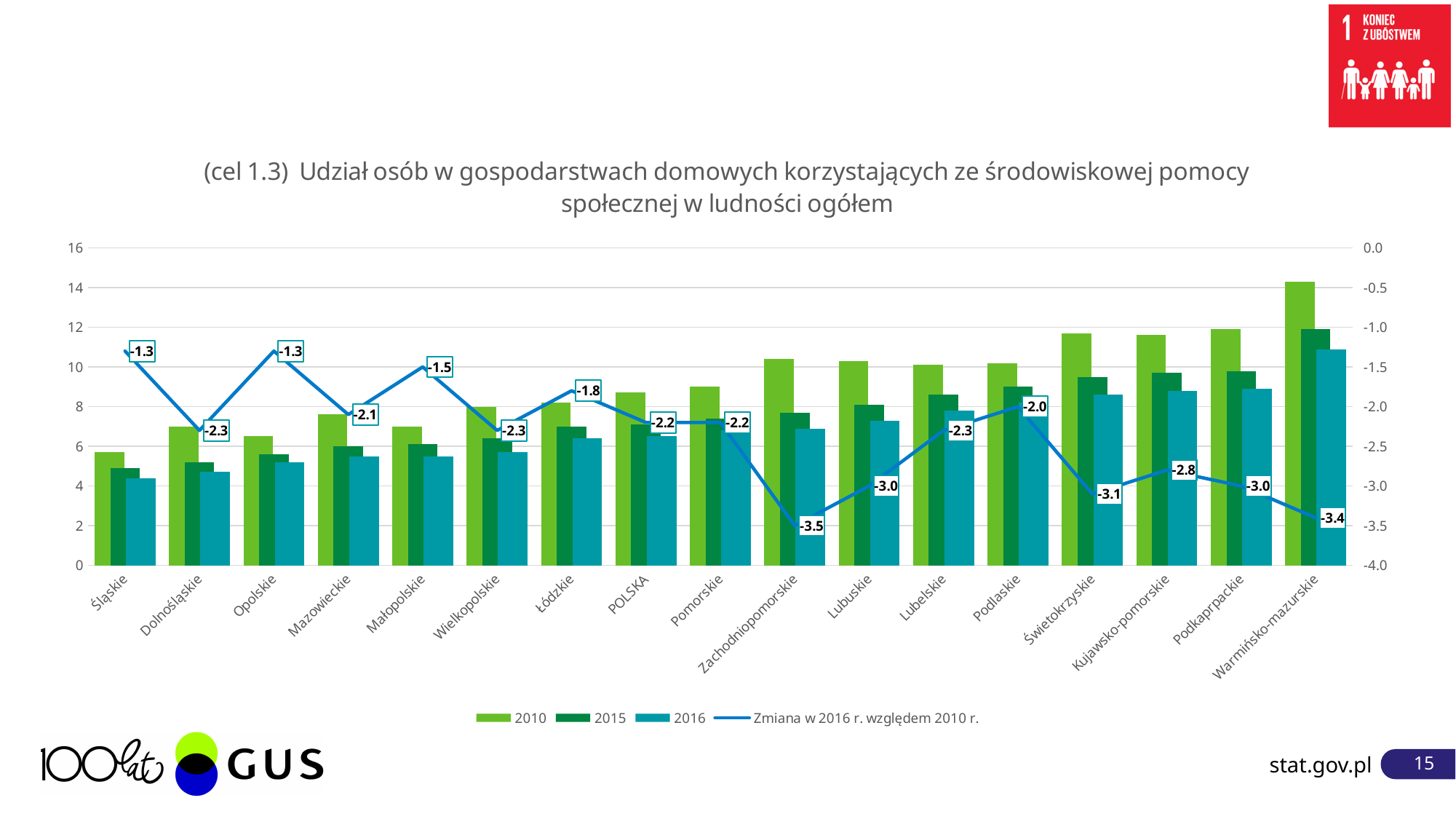
Which category has the lowest 2010 bar? Śląskie What is the value of the line 'Zmiana w 2016 r. względem 2010 r.' for Kujawsko-pomorskie? -2.8 Is the 2016 value for Śląskie greater or less than 6? less What is the difference between the line values for Śląskie (-1.3) and Zachodniopomorskie (-3.5)? 2.2 Is the 2010 value for Warmińsko-mazurskie greater or less than 12? greater How many series does the legend list? 4 What is the value of the line 'Zmiana w 2016 r. względem 2010 r.' for Zachodniopomorskie? -3.5 Which category has the highest 2010 bar? Warmińsko-mazurskie Which category has the lowest value on the line 'Zmiana w 2016 r. względem 2010 r.'? Zachodniopomorskie How many categories are shown on the x axis? 17 Which has the larger line value, Lubuskie or Podlaskie? Podlaskie What is the value of the line 'Zmiana w 2016 r. względem 2010 r.' for POLSKA? -2.2